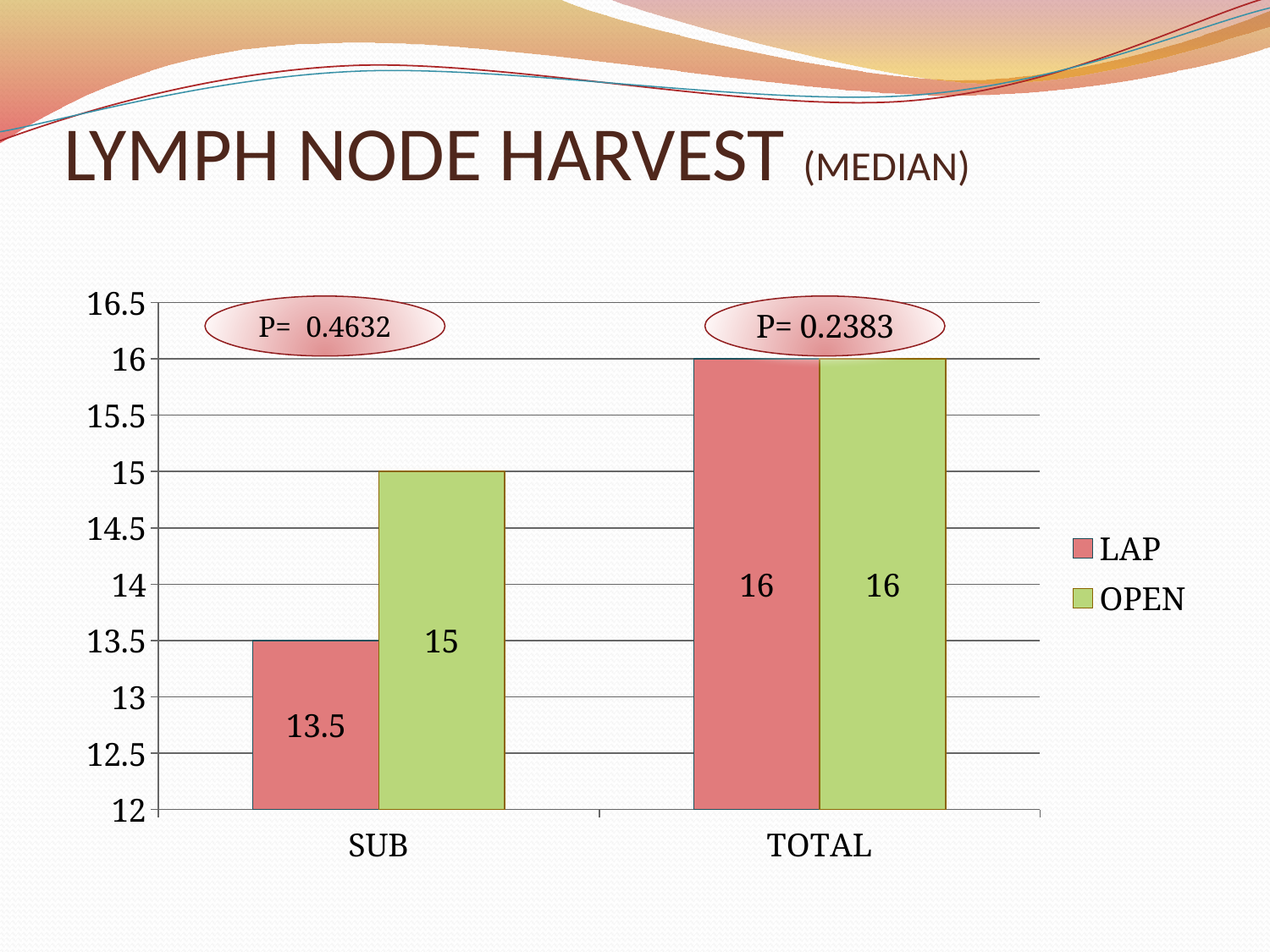
What kind of chart is shown on the slide? Bar chart How many categories are shown on the x axis? 2 For SUB, which series has the larger value, LAP or OPEN? OPEN What is the OPEN value for SUB? 15 What is the difference between the OPEN and LAP values for SUB? 1.5 What P value is shown above the TOTAL bars? P= 0.2383 What is the LAP value for SUB? 13.5 Which category has the highest OPEN value? TOTAL What is the LAP value for TOTAL? 16 What is the OPEN value for TOTAL? 16 How many series does the legend list? 2 Which category has the lowest LAP value? SUB